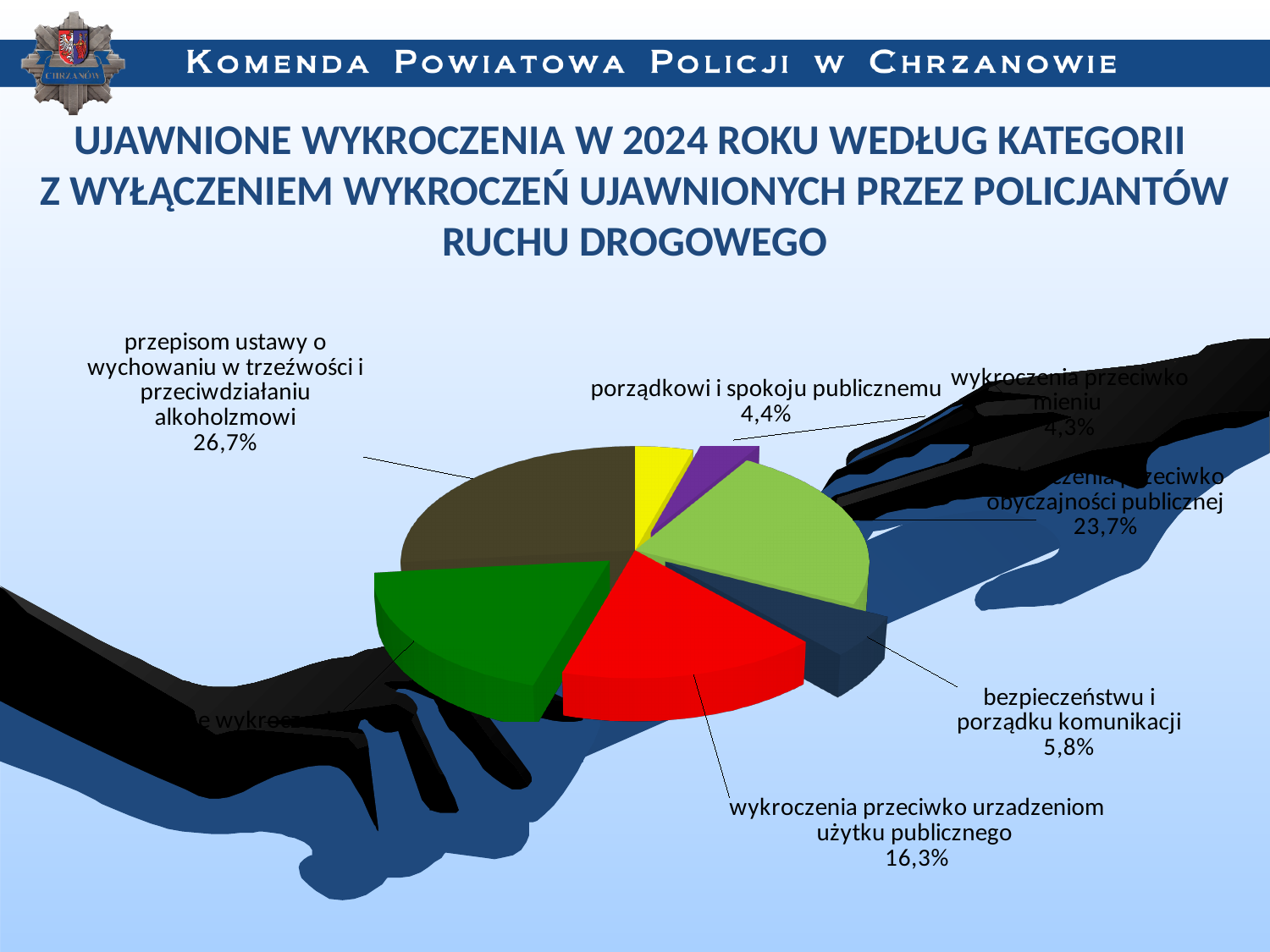
What percentage is shown for 'wykroczenia przeciwko obyczajności publicznej'? 23,7% What percentage is shown for 'wykroczenia przeciwko urzadzeniom użytku publicznego'? 16,3% How many slices does the pie chart have? 7 What percentage is shown for 'bezpieczeństwu i porządku komunikacji'? 5,8% Which is larger: the share for 'wykroczenia przeciwko urzadzeniom użytku publicznego' or for 'bezpieczeństwu i porządku komunikacji'? wykroczenia przeciwko urzadzeniom użytku publicznego What type of chart is shown on the slide? pie chart What percentage is shown for 'wykroczenia przeciwko mieniu'? 4,3% Which labelled category has the largest share of the pie? przepisom ustawy o wychowaniu w trzeźwości i przeciwdziałaniu alkoholzmowi What percentage is shown for 'porządkowi i spokoju publicznemu'? 4,4% What colour is the slice for 'wykroczenia przeciwko urzadzeniom użytku publicznego'? red What share of the pie is labelled 'przepisom ustawy o wychowaniu w trzeźwości i przeciwdziałaniu alkoholzmowi'? 26,7% What is the difference in percentage points between the share for 'przepisom ustawy o wychowaniu w trzeźwości i przeciwdziałaniu alkoholzmowi' and 'wykroczenia przeciwko obyczajności publicznej'? 3 percentage points